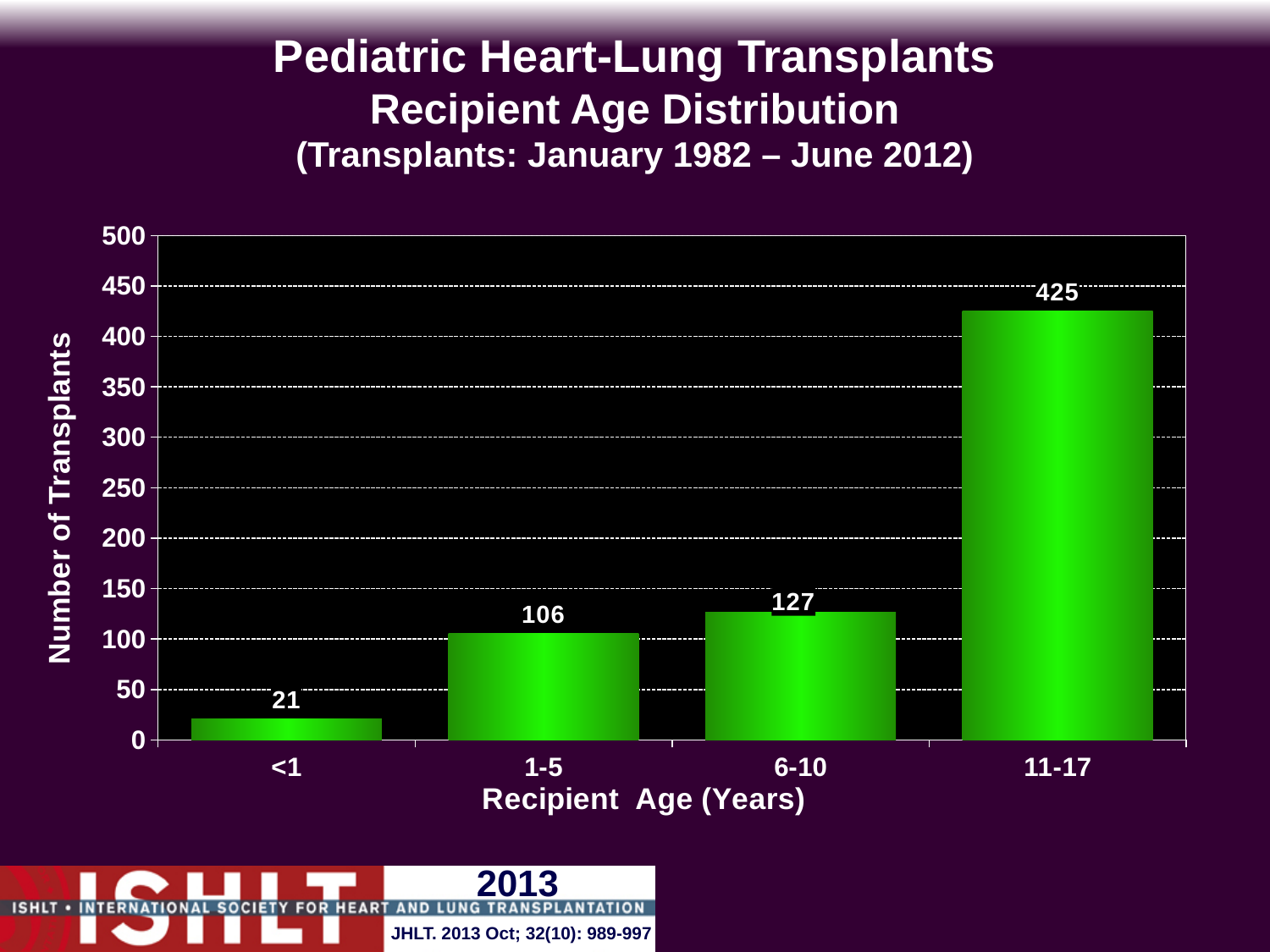
What is the difference in number of transplants between the 11-17 and 6-10 age groups? 298 Which recipient age group has the highest number of transplants? 11-17 How many recipient age groups are shown on the x axis? 4 What is the number of transplants for the <1 age group? 21 How many transplants are shown for recipients aged 11-17? 425 Which recipient age group has the lowest number of transplants? <1 What is the label of the y axis? Number of Transplants What is the number of transplants for recipients aged 6-10? 127 What is the difference in number of transplants between the 1-5 and <1 age groups? 85 What type of chart is shown on the slide? bar chart Which age group has more transplants, 1-5 or 6-10? 6-10 Is the number of transplants for the 11-17 age group greater or less than 400? greater